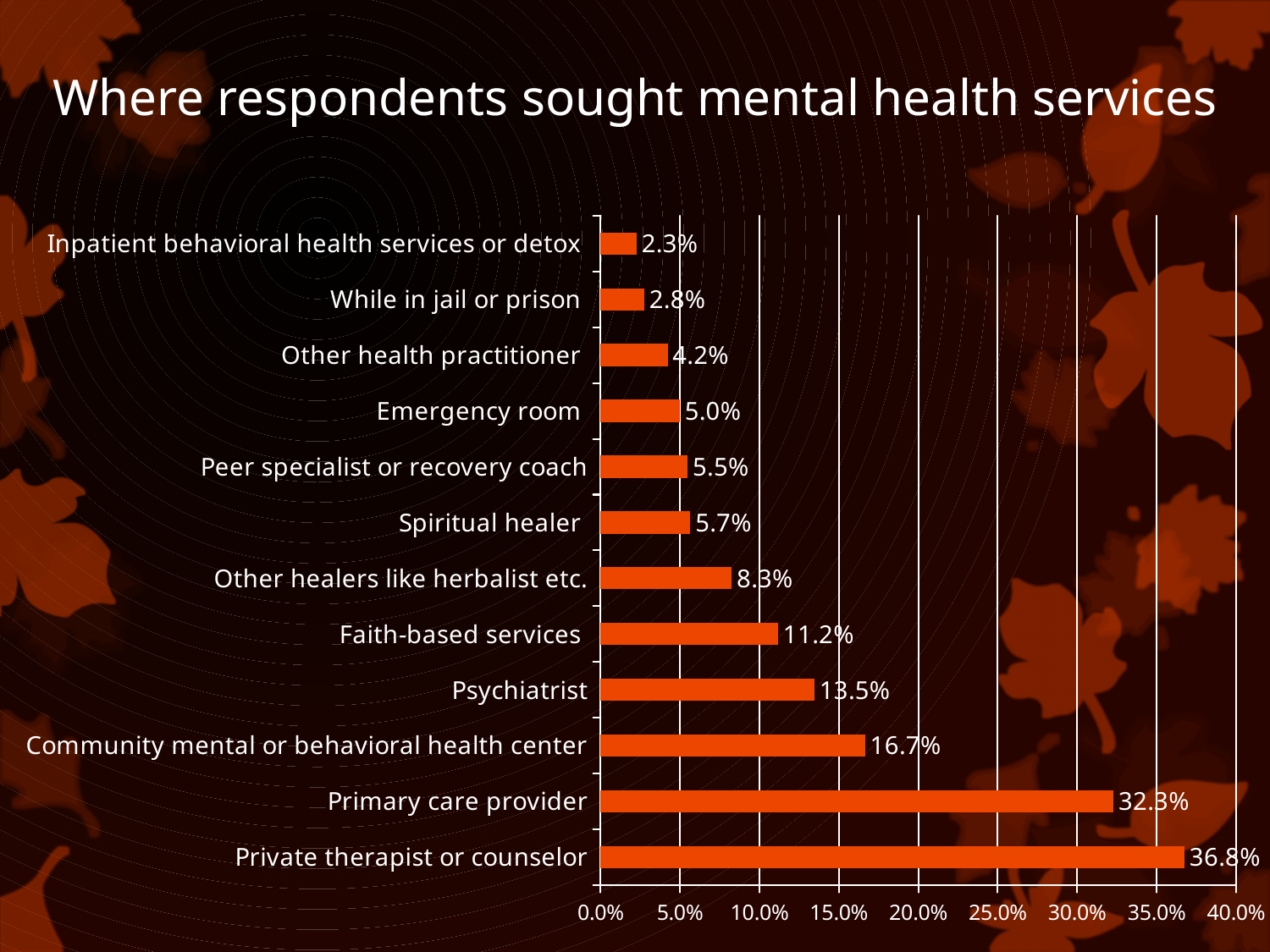
What is the difference between the values for Primary care provider and Community mental or behavioral health center? 15.6% How many categories are shown in the chart? 12 Which is larger, the value for Faith-based services or the value for Other healers like herbalist etc.? Faith-based services What percentage of respondents sought mental health services from a private therapist or counselor? 36.8% What is the value shown for While in jail or prison? 2.8% Which category has the lowest value? Inpatient behavioral health services or detox What is the title of the chart? Where respondents sought mental health services Which category has the highest value? Private therapist or counselor What is the value shown for Psychiatrist? 13.5% What kind of chart is shown on the slide? Bar chart Is the value for Primary care provider greater or less than 30.0%? greater What percentage is shown for Emergency room? 5.0%